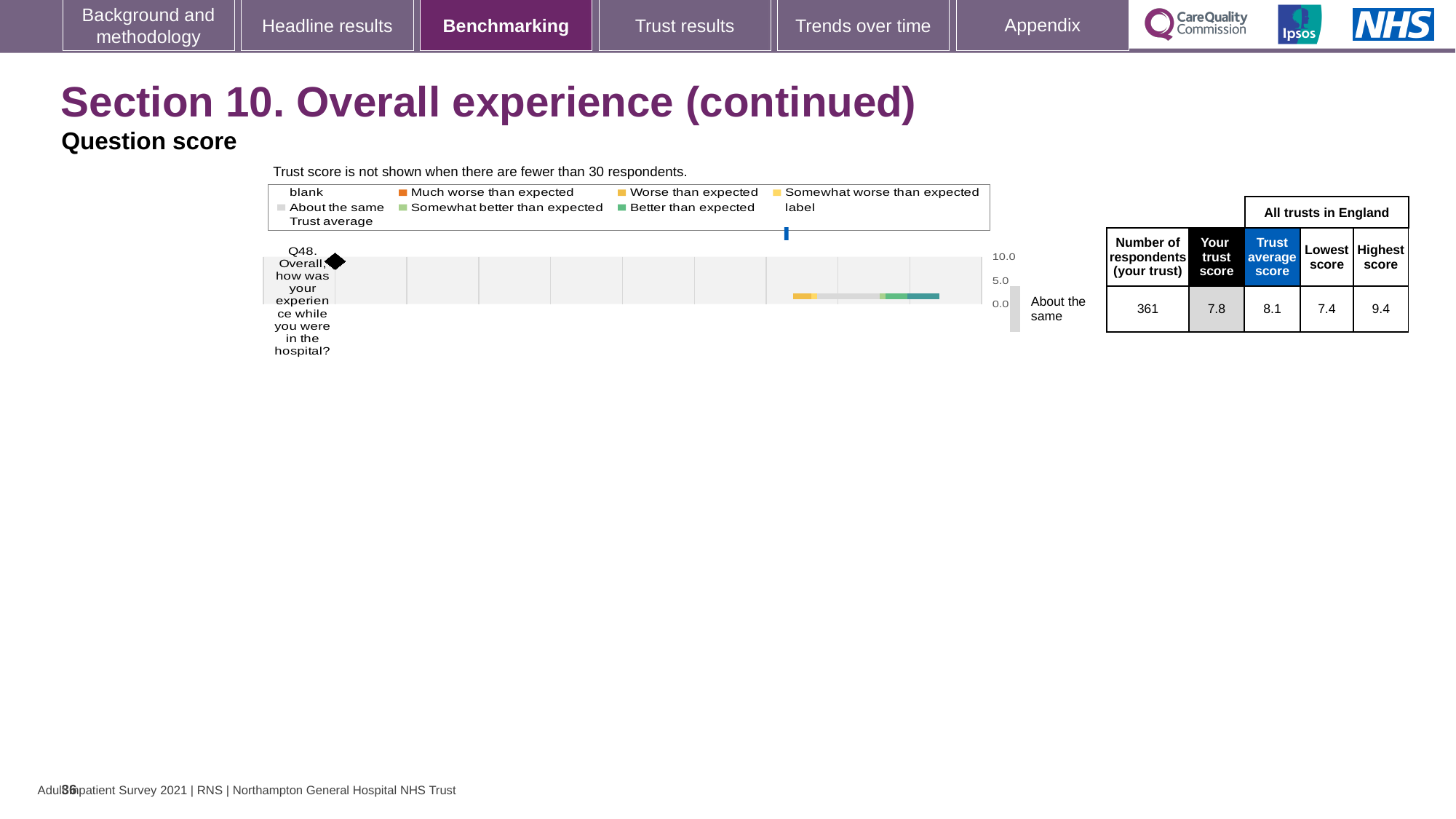
Which is larger for Q48: your trust score or the trust average score? Trust average score What is the highest score for Q48 among all trusts in England? 9.4 What is the number of respondents (your trust) for Q48? 361 What is your trust score for Q48? 7.8 What kind of chart is used to show the Q48 benchmarking result? Bar chart What is the trust average score for Q48 across all trusts in England? 8.1 What is the lowest score for Q48 among all trusts in England? 7.4 Below how many respondents is the trust score not shown, according to the note above the chart? 30 By how much does the trust average score exceed your trust score for Q48? 0.3 What benchmark category is shown next to the Q48 chart? About the same How many questions are plotted in the benchmarking chart? 1 What is the difference between the highest score and the lowest score for Q48? 2.0